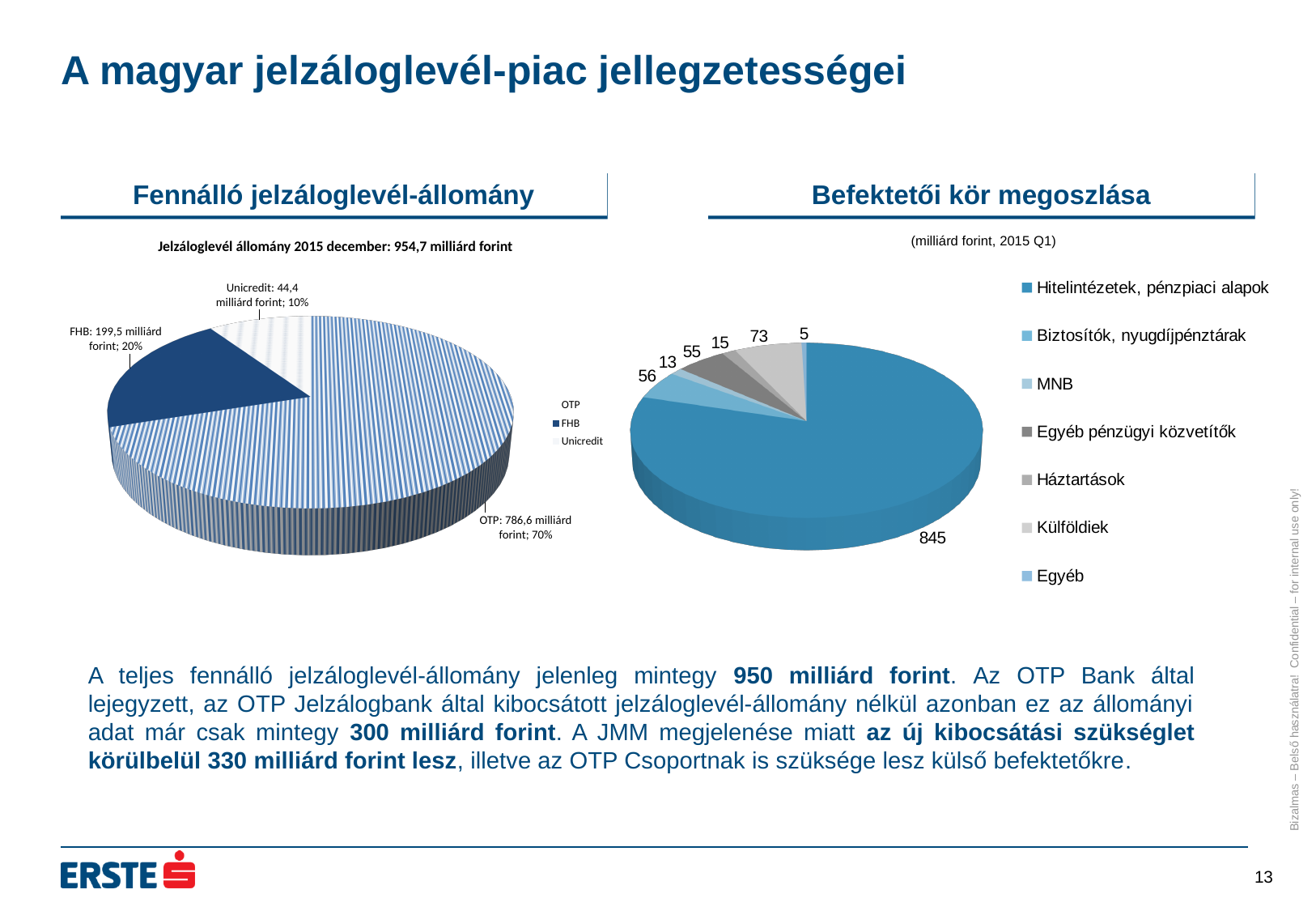
In the 'Fennálló jelzáloglevél-állomány' chart, what is the value for Unicredit? 44,4 milliárd forint In the 'Fennálló jelzáloglevél-állomány' chart, what is the difference between the OTP and FHB values? 587,1 milliárd forint In the 'Fennálló jelzáloglevél-állomány' chart, how many slices does the pie have? 3 In the 'Fennálló jelzáloglevél-állomány' chart, which issuer has the smallest slice? Unicredit In the 'Befektetői kör megoszlása' chart, what is the value for Hitelintézetek, pénzpiaci alapok? 845 In the 'Fennálló jelzáloglevél-állomány' chart, what is the value for OTP? 786,6 milliárd forint In the 'Befektetői kör megoszlása' chart, what is the largest value shown? 845 In the 'Fennálló jelzáloglevél-állomány' chart, what share of the pie does FHB have? 20% What unit and period are given under the title of the 'Befektetői kör megoszlása' chart? milliárd forint, 2015 Q1 How many entries does the legend of the 'Befektetői kör megoszlása' chart list? 7 What kind of chart is the 'Fennálló jelzáloglevél-állomány' chart? pie chart In the 'Befektetői kör megoszlása' chart, what is the smallest value shown? 5